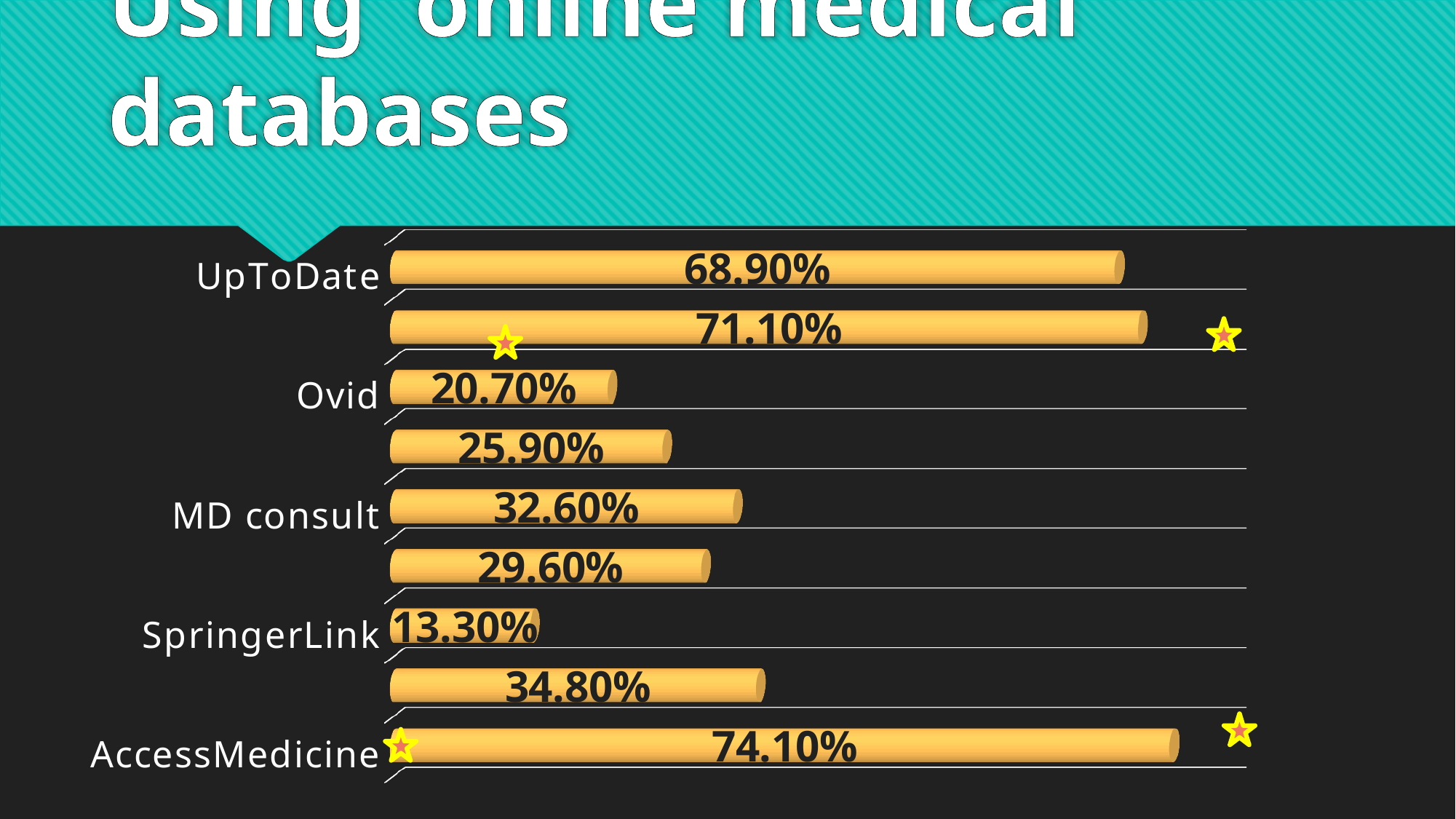
What is the difference between the values for MD consult and Ovid? 11.90% What kind of chart is shown on the slide? Bar chart Which category has the lowest value? SpringerLink Which is larger, the value for Ovid or the value for MD consult? MD consult What is the value for AccessMedicine? 74.10% What is the value for Ovid? 20.70% What is the value for SpringerLink? 13.30% Which category has the highest value? AccessMedicine How many bars are plotted in the chart? 9 What is the value for UpToDate? 68.90% What is the value for MD consult? 32.60% What is the difference between the values for AccessMedicine and UpToDate? 5.20%